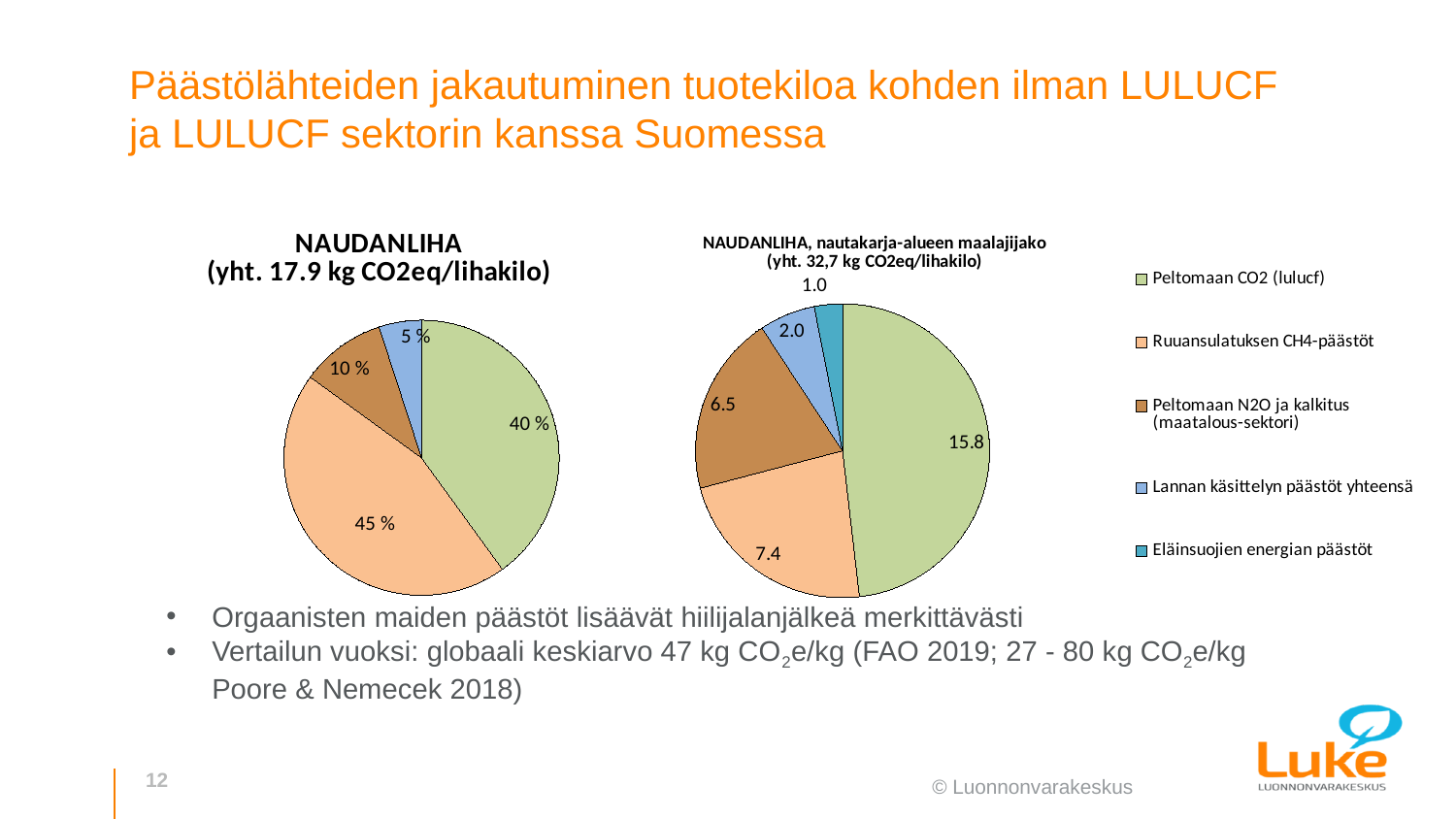
In the right pie chart 'NAUDANLIHA, nautakarja-alueen maalajijako', which category has the smallest slice? Eläinsuojien energian päästöt How many slices does the right pie chart 'NAUDANLIHA, nautakarja-alueen maalajijako' have? 5 In the right pie chart 'NAUDANLIHA, nautakarja-alueen maalajijako', what is the value for Peltomaan CO2 (lulucf)? 15.8 In the right pie chart 'NAUDANLIHA, nautakarja-alueen maalajijako', which category has the largest slice? Peltomaan CO2 (lulucf) In the right pie chart 'NAUDANLIHA, nautakarja-alueen maalajijako', which is larger: Peltomaan N2O ja kalkitus (maatalous-sektori) or Lannan käsittelyn päästöt yhteensä? Peltomaan N2O ja kalkitus (maatalous-sektori) In the left pie chart 'NAUDANLIHA (yht. 17.9 kg CO2eq/lihakilo)', what is the value of the largest slice? 45 % In the right pie chart 'NAUDANLIHA, nautakarja-alueen maalajijako', what is the value for Ruuansulatuksen CH4-päästöt? 7.4 What kind of chart is the left chart titled 'NAUDANLIHA (yht. 17.9 kg CO2eq/lihakilo)'? Pie chart In the left pie chart 'NAUDANLIHA (yht. 17.9 kg CO2eq/lihakilo)', what is the value of the smallest slice? 5 % In the right pie chart 'NAUDANLIHA, nautakarja-alueen maalajijako', what is the difference between the values for Peltomaan CO2 (lulucf) and Ruuansulatuksen CH4-päästöt? 8.4 How many entries does the legend shared by the pie charts list? 5 How many slices does the left pie chart 'NAUDANLIHA (yht. 17.9 kg CO2eq/lihakilo)' have? 4